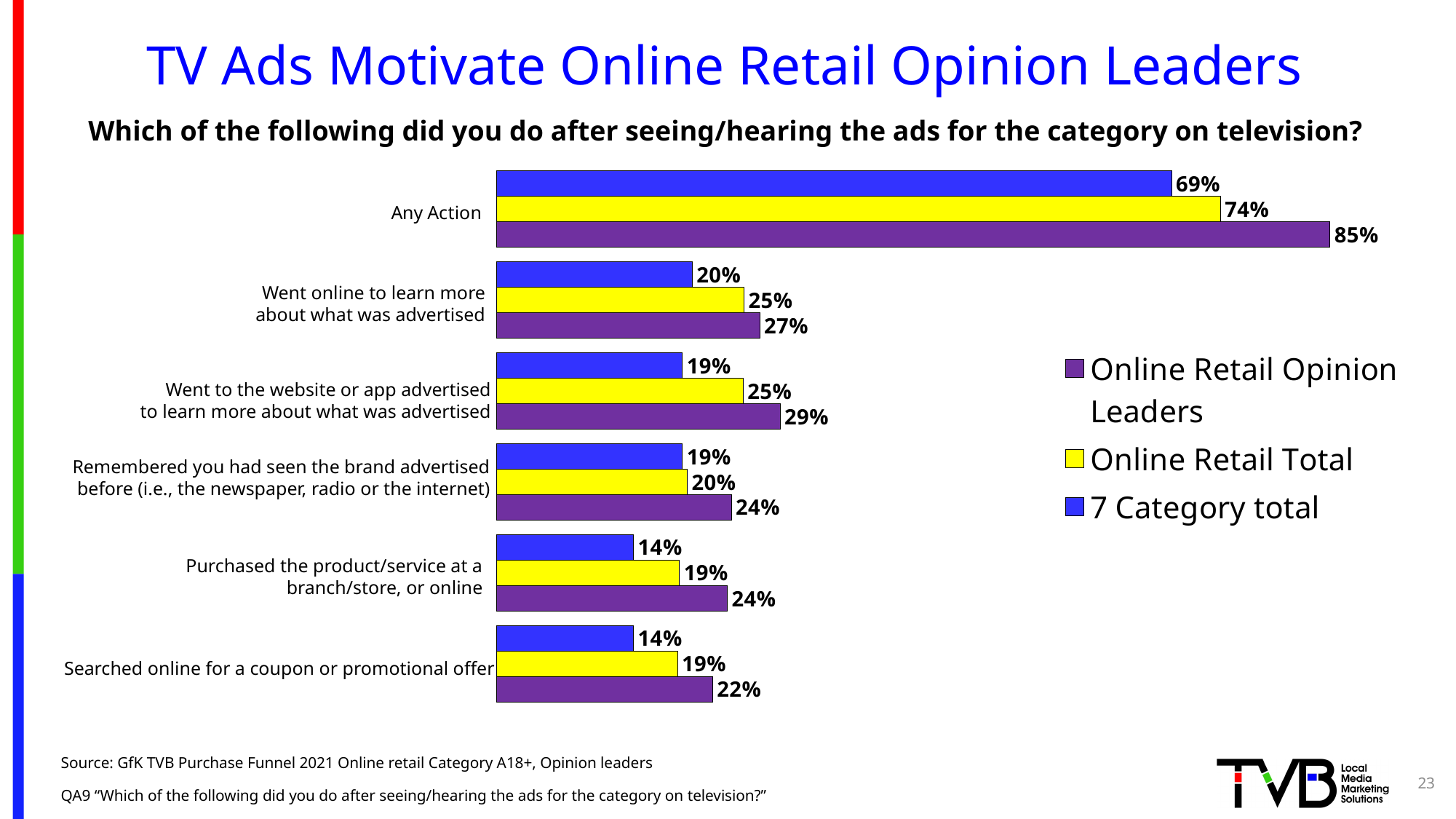
What is the value for 7 Category total for Went online to learn more about what was advertised? 20% What is the value for Online Retail Opinion Leaders for Any Action? 85% What is the value for Online Retail Total for Purchased the product/service at a branch/store, or online? 19% Which series is shown in yellow in the legend? Online Retail Total Which category has the highest value for Online Retail Opinion Leaders? Any Action For Went to the website or app advertised to learn more about what was advertised, which is larger: Online Retail Opinion Leaders or Online Retail Total? Online Retail Opinion Leaders Which category has the lowest value for Online Retail Opinion Leaders? Searched online for a coupon or promotional offer How many series does the legend list? 3 How many categories are shown on the chart? 6 What is the difference between the Online Retail Total value and the 7 Category total value for Remembered you had seen the brand advertised before? 1% What kind of chart is shown on the slide? Bar chart What is the difference between the Online Retail Opinion Leaders value and the 7 Category total value for Any Action? 16%